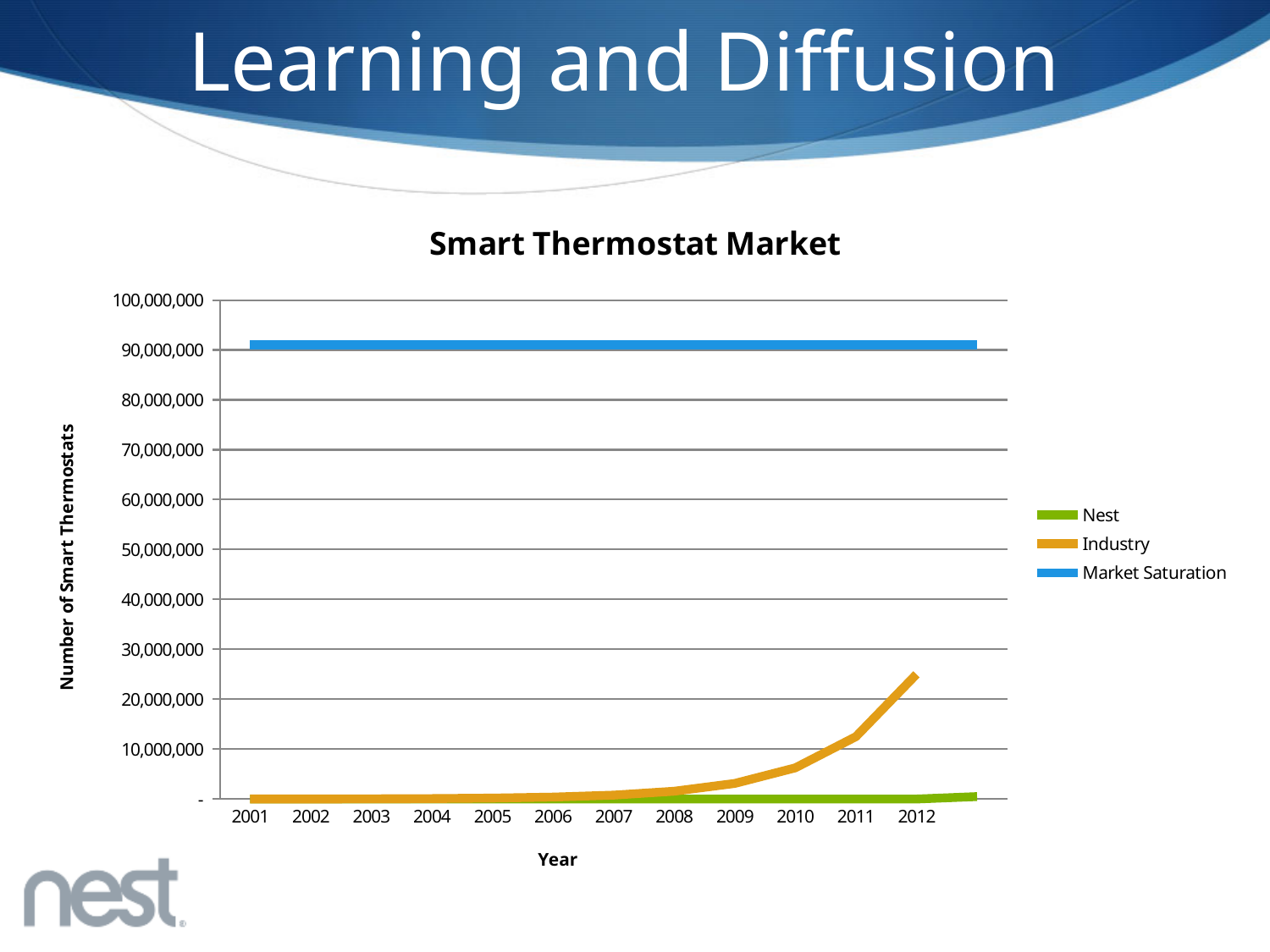
What is the label of the vertical axis? Number of Smart Thermostats What is the title of the chart? Smart Thermostat Market Is the value for Market Saturation greater or less than 90,000,000? greater What kind of chart is shown on the slide? line chart In 2012, which is larger, the value for Industry or the value for Nest? Industry Which series has the highest values across the chart? Market Saturation Is the value for Nest in 2012 greater or less than 10,000,000? less Is the value for Industry in 2012 greater or less than 30,000,000? less How many series does the legend list? 3 How many years are shown on the x axis? 12 Does the Industry series rise or fall from 2001 to 2012? rise